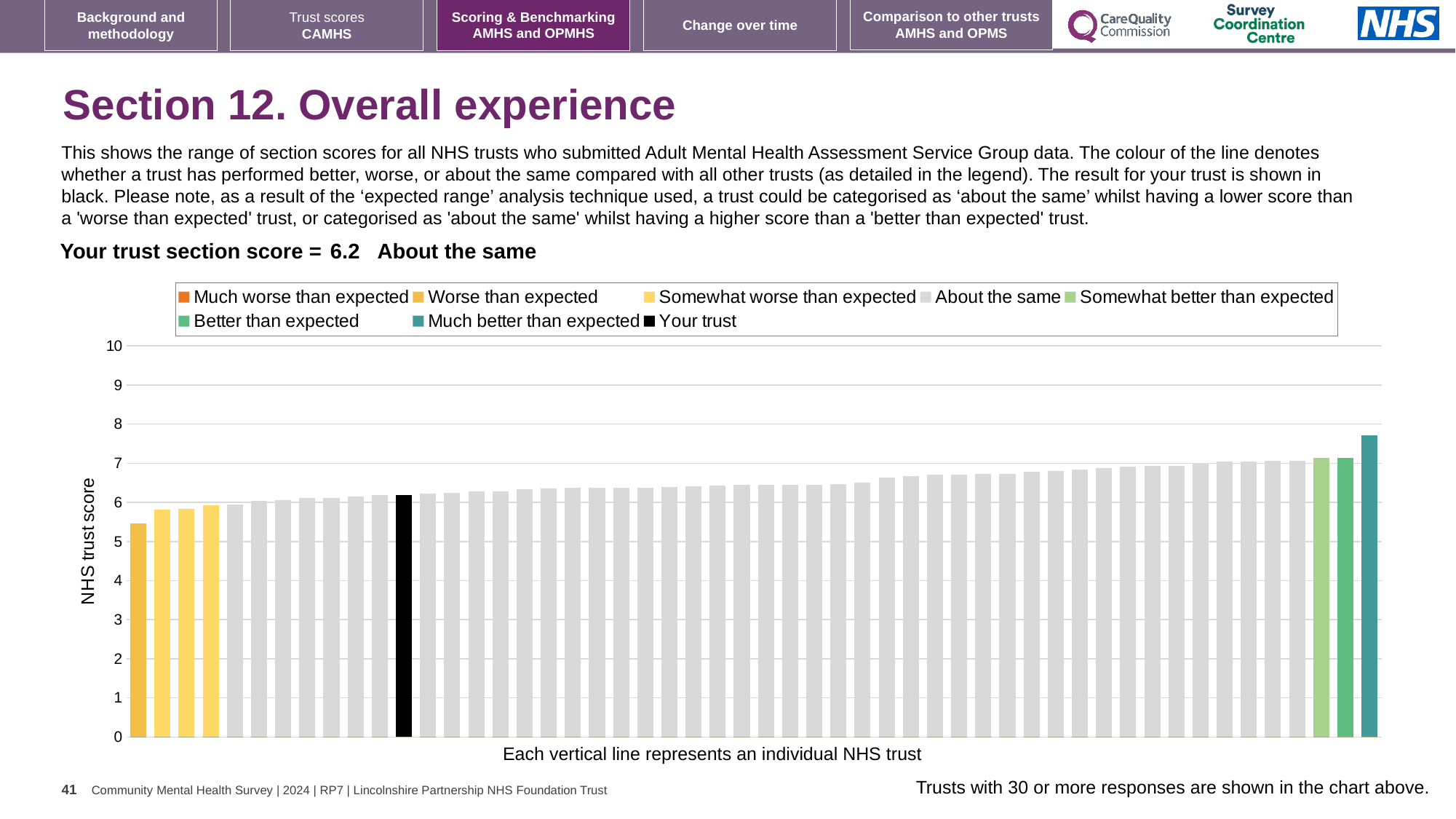
How many entries does the chart legend list? 8 Which category is your trust placed in for this section? About the same Is the value of the tallest bar greater or less than 7? greater What kind of chart is shown on the slide? bar chart Do the bar values rise or fall from left to right across the chart? rise What is the label of the vertical axis? NHS trust score Which legend category does the tallest bar belong to? Much better than expected What is the section score for your trust shown on the slide? 6.2 Is the value of the black 'Your trust' bar greater or less than 5? greater Is the value of the shortest bar greater or less than 6? less What is the highest value shown on the vertical axis? 10